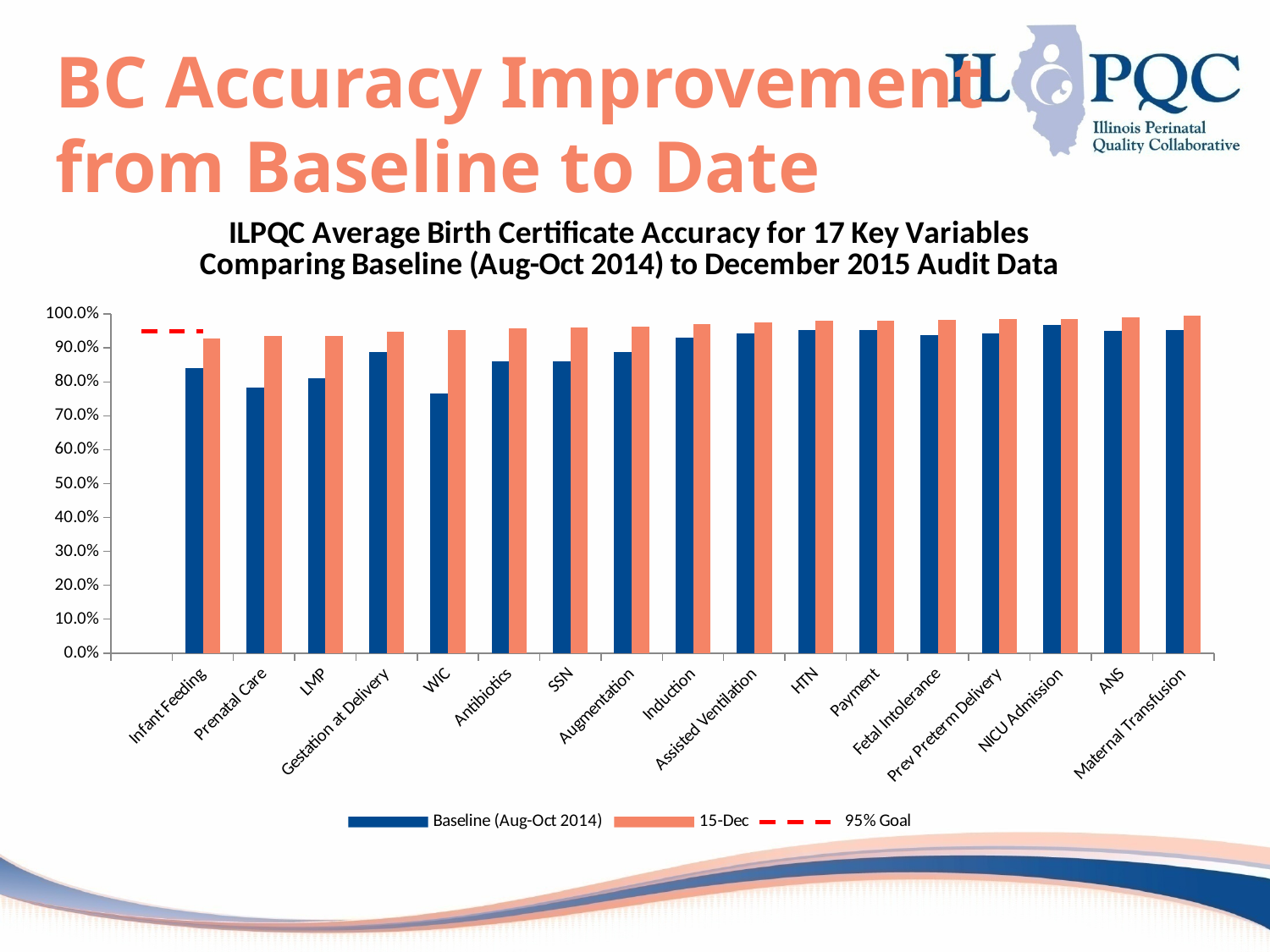
How many key variables (categories) are plotted along the x axis? 17 Is the Baseline (Aug-Oct 2014) value for Infant Feeding greater or less than 80.0%? greater What does the red dashed line in the chart represent? 95% Goal How many entries does the legend list? 3 What kind of chart is shown on the slide? bar chart Which is larger: the Baseline (Aug-Oct 2014) value for WIC or the Baseline value for HTN? HTN Is the Baseline (Aug-Oct 2014) value for WIC greater or less than 80.0%? less Is the 15-Dec value for Induction greater or less than 90.0%? greater What is the title of the chart? ILPQC Average Birth Certificate Accuracy for 17 Key Variables Comparing Baseline (Aug-Oct 2014) to December 2015 Audit Data For Infant Feeding, which is larger: the Baseline (Aug-Oct 2014) value or the 15-Dec value? 15-Dec Which variable has the lowest Baseline (Aug-Oct 2014) accuracy? WIC